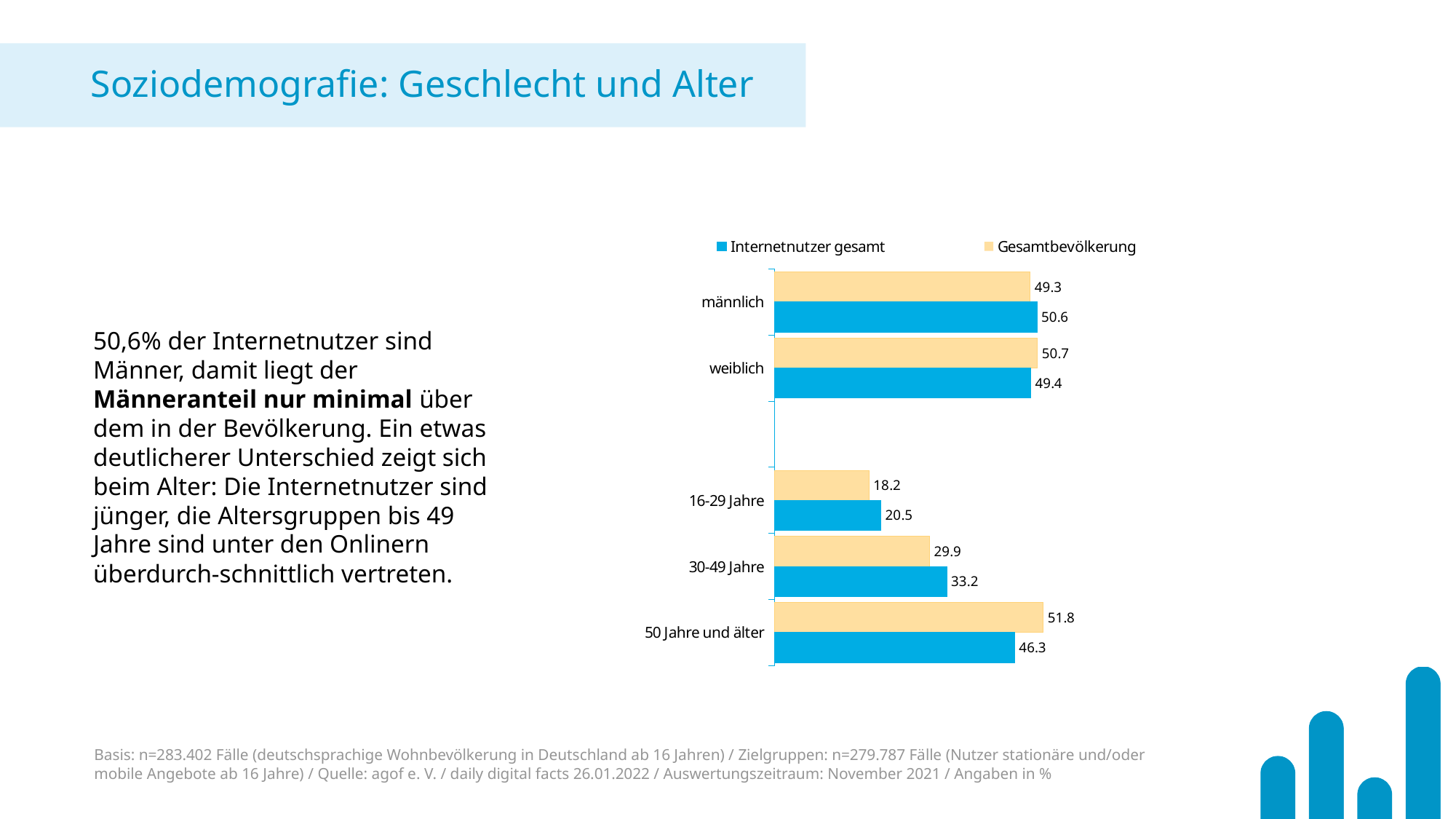
How many series does the legend list? 2 Among the age groups, which category has the highest Gesamtbevölkerung value? 50 Jahre und älter Which colour represents the Internetnutzer gesamt series? Blue Among the age groups, which category has the lowest Internetnutzer gesamt value? 16-29 Jahre What is the difference between the Internetnutzer gesamt and Gesamtbevölkerung values for 30-49 Jahre? 3.3 What kind of chart is shown on the slide? Bar chart What is the value for Gesamtbevölkerung in the 30-49 Jahre category? 29.9 What is the value for Gesamtbevölkerung in the 16-29 Jahre category? 18.2 For the weiblich category, which series has the larger value, Internetnutzer gesamt or Gesamtbevölkerung? Gesamtbevölkerung What is the difference between the Gesamtbevölkerung and Internetnutzer gesamt values for 50 Jahre und älter? 5.5 What is the value for Internetnutzer gesamt in the 50 Jahre und älter category? 46.3 What is the value for Internetnutzer gesamt in the männlich category? 50.6